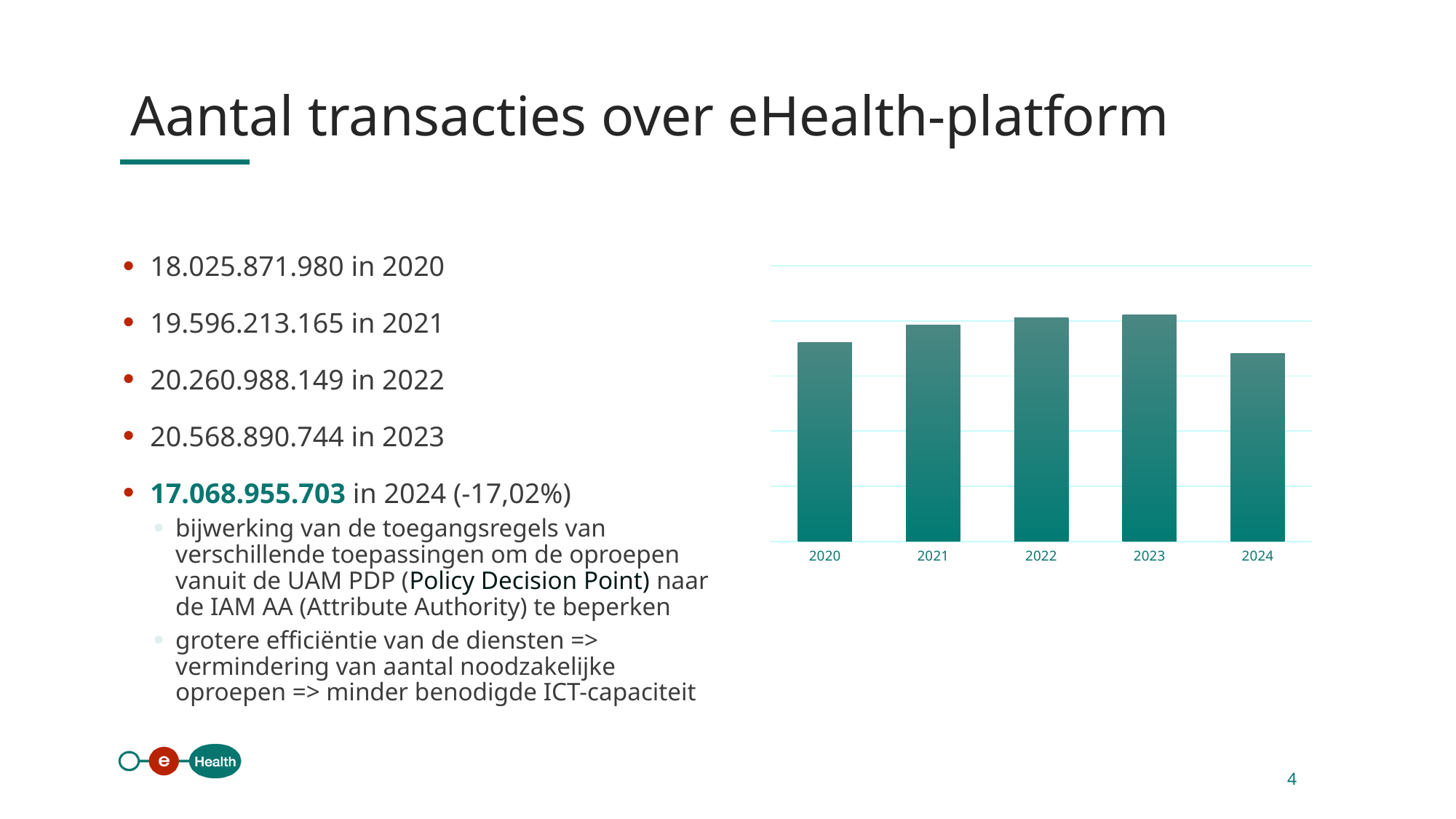
How many years (bars) does the chart show? 5 What is the difference between the 2023 and 2024 transaction counts printed on the slide? 3.499.935.041 How do the values change from 2020 to 2023 along the x axis? they rise Does the value fall or rise from 2023 to 2024? fall Which bar is taller, 2021 or 2022? 2022 What kind of chart is shown on the slide? bar chart What is the number of transactions for 2023 as printed on the slide? 20.568.890.744 Is the bar for 2020 taller or shorter than the bar for 2024? taller What is the number of transactions for 2024 as printed on the slide? 17.068.955.703 What is the title of the slide containing the chart? Aantal transacties over eHealth-platform Which year has the lowest bar in the chart? 2024 Which year has the highest bar in the chart? 2023